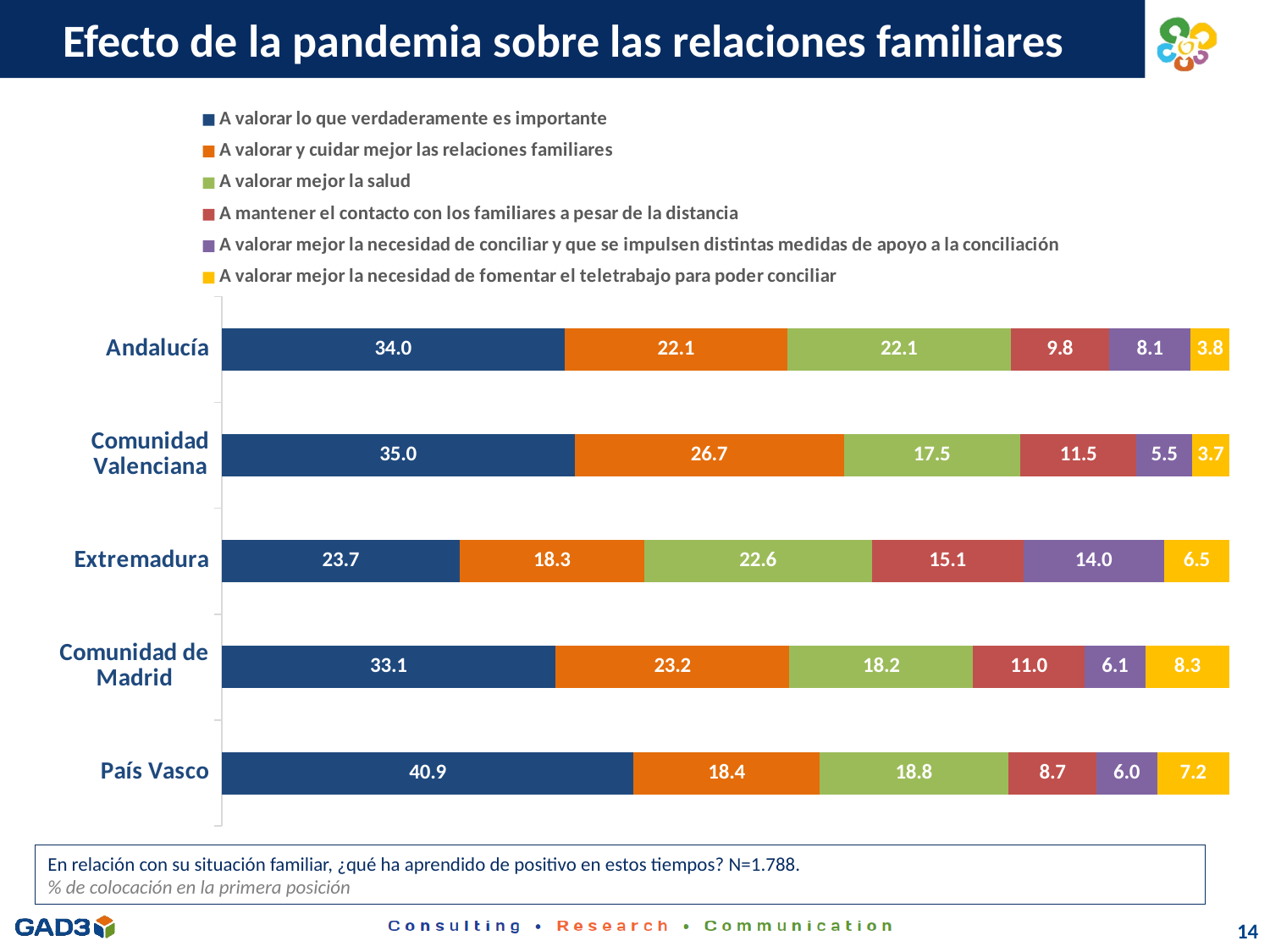
What is the total of the stacked bar for País Vasco? 100.0 What is the value for 'A valorar lo que verdaderamente es importante' in País Vasco? 40.9 How many series does the legend list? 6 Which is larger: the 'A mantener el contacto con los familiares a pesar de la distancia' value for Extremadura or for Andalucía? Extremadura What type of chart is shown on the slide? Stacked bar chart What is the value for 'A valorar mejor la necesidad de fomentar el teletrabajo para poder conciliar' in Comunidad de Madrid? 8.3 Which region has the lowest value for 'A valorar mejor la necesidad de conciliar y que se impulsen distintas medidas de apoyo a la conciliación'? Comunidad Valenciana What is the title of the slide? Efecto de la pandemia sobre las relaciones familiares Which region has the highest value for 'A valorar lo que verdaderamente es importante'? País Vasco What is the difference between the 'A valorar lo que verdaderamente es importante' values for País Vasco and Extremadura? 17.2 How many regions (categories) are shown in the chart? 5 What is the value for 'A valorar y cuidar mejor las relaciones familiares' in Comunidad Valenciana? 26.7